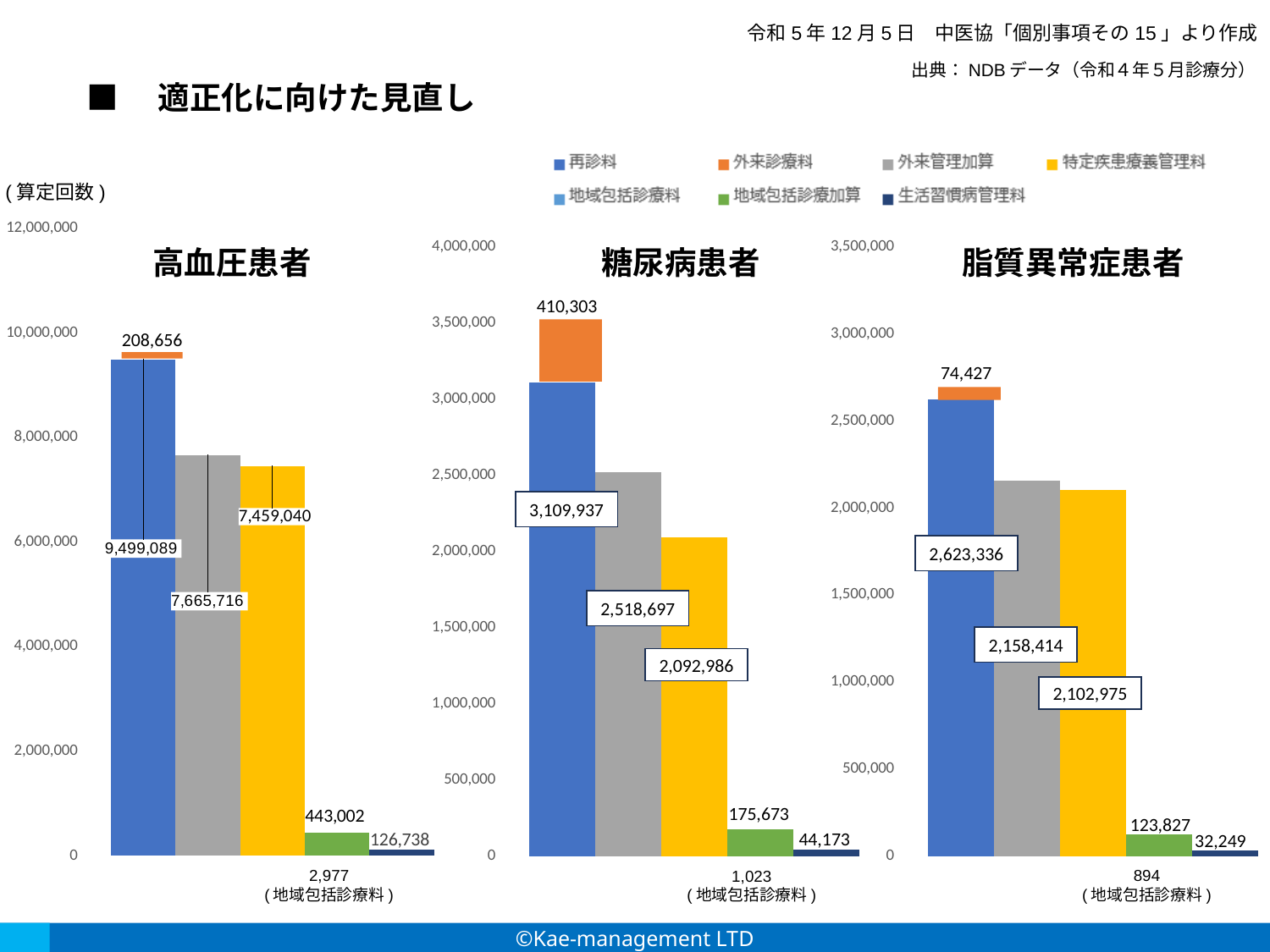
How many series does the legend list? 7 In the 高血圧患者 chart, what is the value for 再診料? 9,499,089 In the 糖尿病患者 chart, is the value for 外来管理加算 greater or less than 2,000,000? greater In the 脂質異常症患者 chart, which is larger, 地域包括診療加算 or 生活習慣病管理料? 地域包括診療加算 In the 高血圧患者 chart, which series has the highest value? 再診料 In the 糖尿病患者 chart, what is the value for 外来診療料? 410,303 In the 脂質異常症患者 chart, what is the value for 特定疾患療養管理料? 2,102,975 In the 脂質異常症患者 chart, what is the value for 地域包括診療料? 894 What colour represents 特定疾患療養管理料 in the legend? yellow What kind of chart is the 糖尿病患者 chart? bar chart In the 高血圧患者 chart, what is the difference between 外来管理加算 and 特定疾患療養管理料? 206,676 In the 糖尿病患者 chart, which series has the lowest value? 地域包括診療料